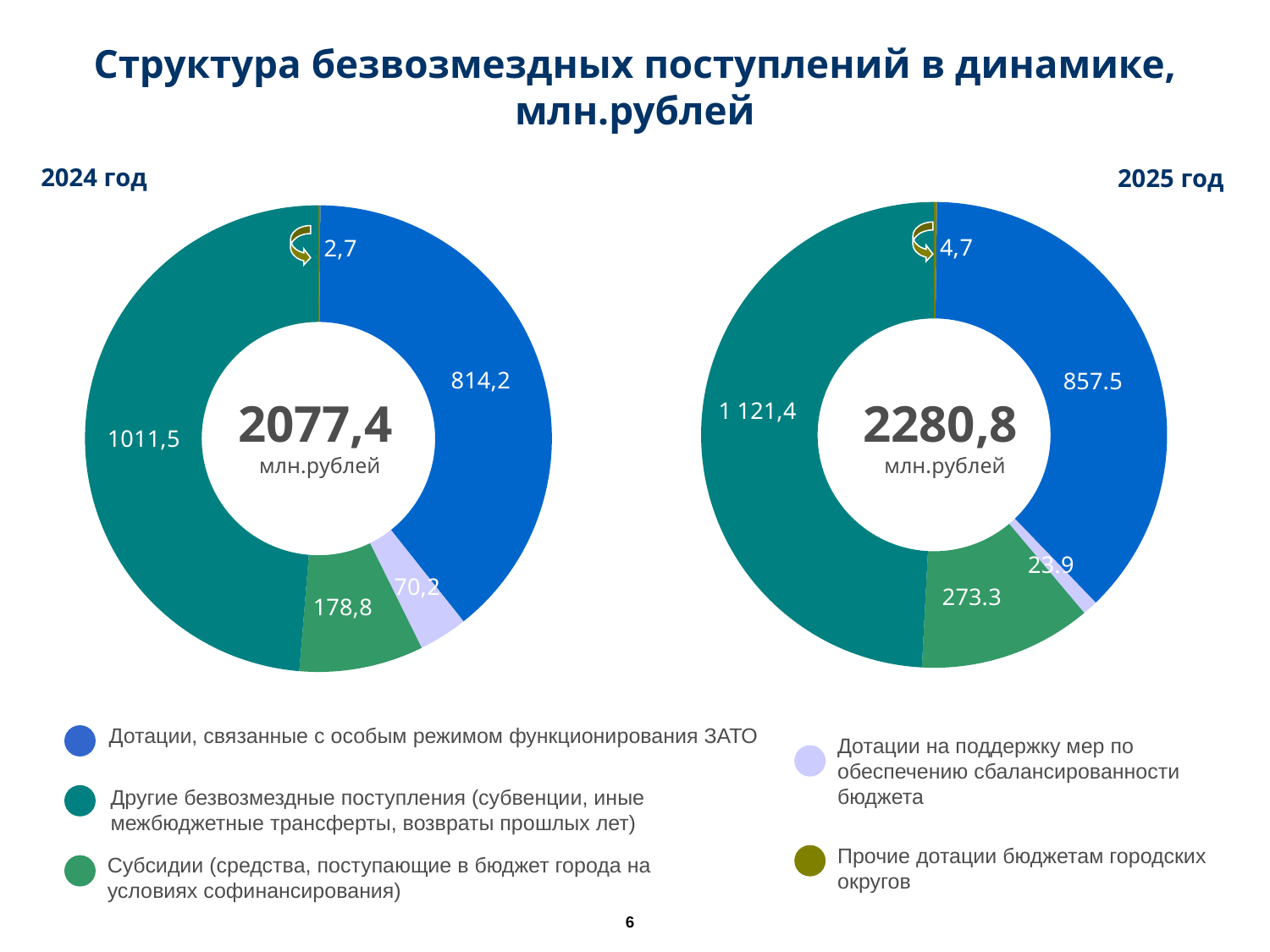
In the 2024 год chart, what is the value for Дотации, связанные с особым режимом функционирования ЗАТО? 814,2 In the 2025 год chart, what is the value for Субсидии (средства, поступающие в бюджет города на условиях софинансирования)? 273.3 In the 2025 год chart, what is the value for Прочие дотации бюджетам городских округов? 4,7 In the 2025 год chart, which category has the smallest value? Прочие дотации бюджетам городских округов What is the total shown in the centre of the 2025 год chart? 2280,8 млн.рублей How many categories does the legend list for the charts? 5 In the 2024 год chart, which category has the largest value? Другие безвозмездные поступления (субвенции, иные межбюджетные трансферты, возвраты прошлых лет) In the 2024 год chart, which is larger: Субсидии or Дотации на поддержку мер по обеспечению сбалансированности бюджета? Субсидии What kind of chart is used for the 2024 год chart? Pie (donut) chart What is the difference between the Субсидии values in the 2025 год chart (273.3) and the 2024 год chart (178,8)? 94,5 In the 2025 год chart, what is the value for Другие безвозмездные поступления (субвенции, иные межбюджетные трансферты, возвраты прошлых лет)? 1 121,4 In the 2024 год chart, what is the value for Дотации на поддержку мер по обеспечению сбалансированности бюджета? 70,2